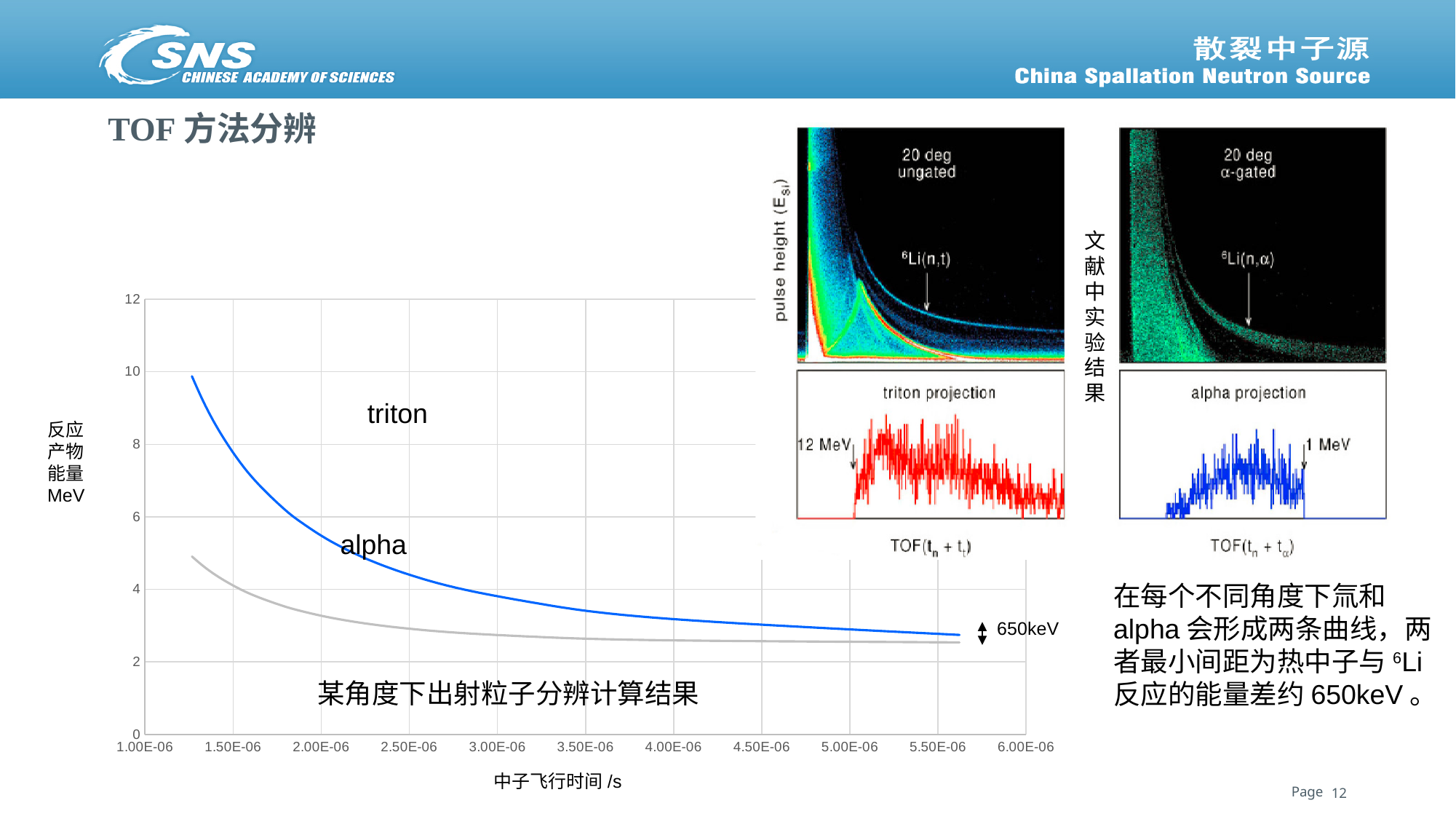
In the large line chart on the left, is the triton energy at 5.00E-06 s greater or less than 4 MeV? less In the 'triton projection' plot on the right of the slide, what energy value is marked with an arrow? 12 MeV In the large line chart on the left, how many curves are plotted? 2 In the large line chart on the left, is the triton energy at 1.50E-06 s greater or less than 6 MeV? greater In the large line chart on the left, what are the two curves labelled? triton and alpha In the large line chart on the left, is the alpha energy at 3.00E-06 s greater or less than 4 MeV? less What kind of chart is the large chart on the left of the slide (反应产物能量 vs 中子飞行时间)? line chart In the large line chart on the left, what energy gap between the two curves is annotated at the right end? 650keV In the large line chart on the left, which curve has the higher energy, triton or alpha? triton In the large line chart on the left, what is the label of the x axis? 中子飞行时间 /s In the large line chart on the left, do the curves rise or fall as the neutron flight time increases? fall